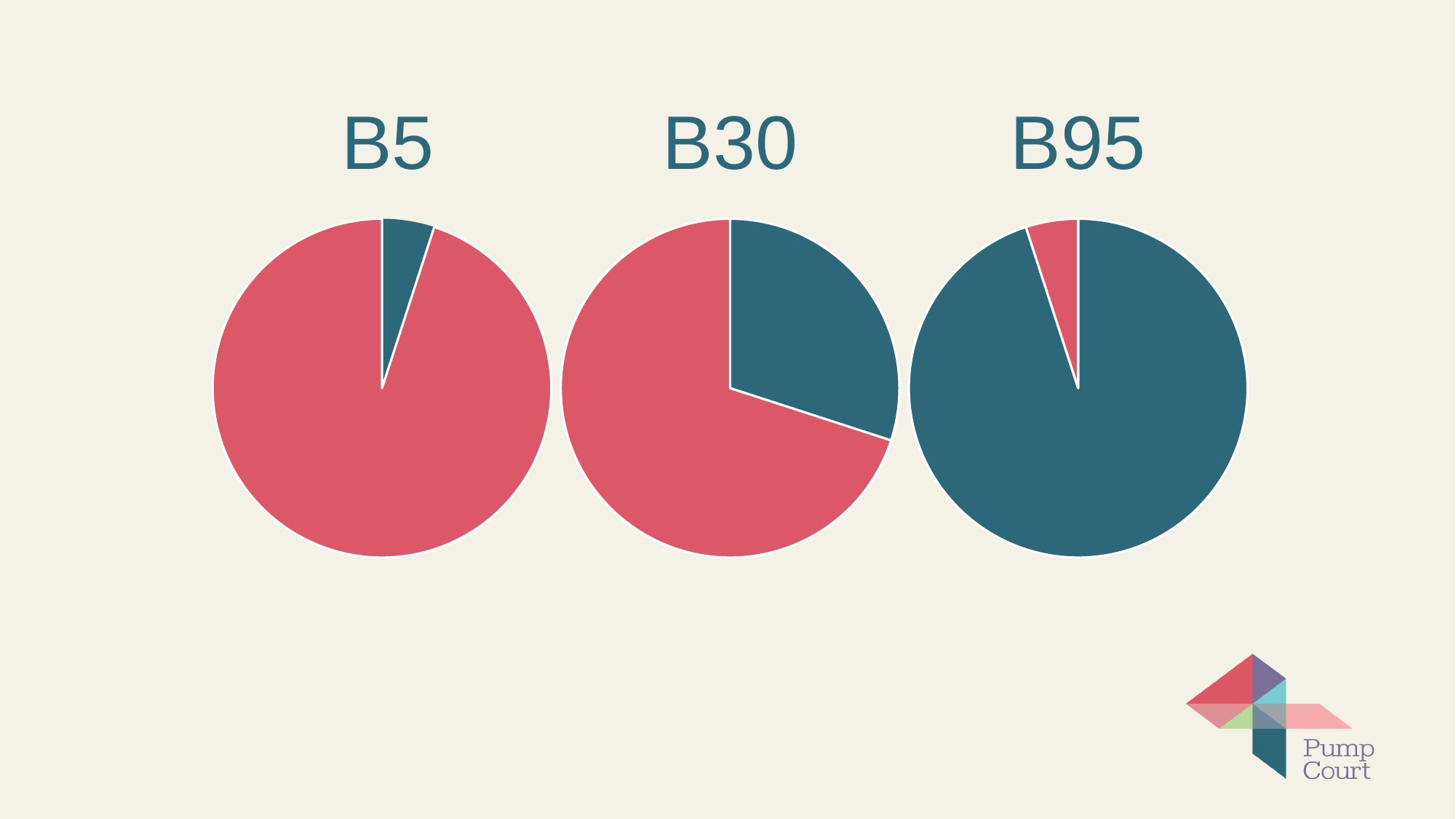
In the pie chart titled B5, which slice is larger, the red slice or the teal slice? the red slice What is the title of the middle pie chart on the slide? B30 What is the title of the rightmost pie chart on the slide? B95 In the pie chart titled B30, which slice is larger, the red slice or the teal slice? the red slice How many slices does the pie chart titled B30 have? 2 Which of the three pie charts has the largest teal slice? B95 How many charts are shown on the slide? 3 What kind of chart is the chart titled B5? pie chart Which of the three pie charts has the smallest red slice? B95 How many slices does the pie chart titled B95 have? 2 In the pie chart titled B95, which slice is larger, the red slice or the teal slice? the teal slice Which of the three pie charts has the smallest teal slice? B5